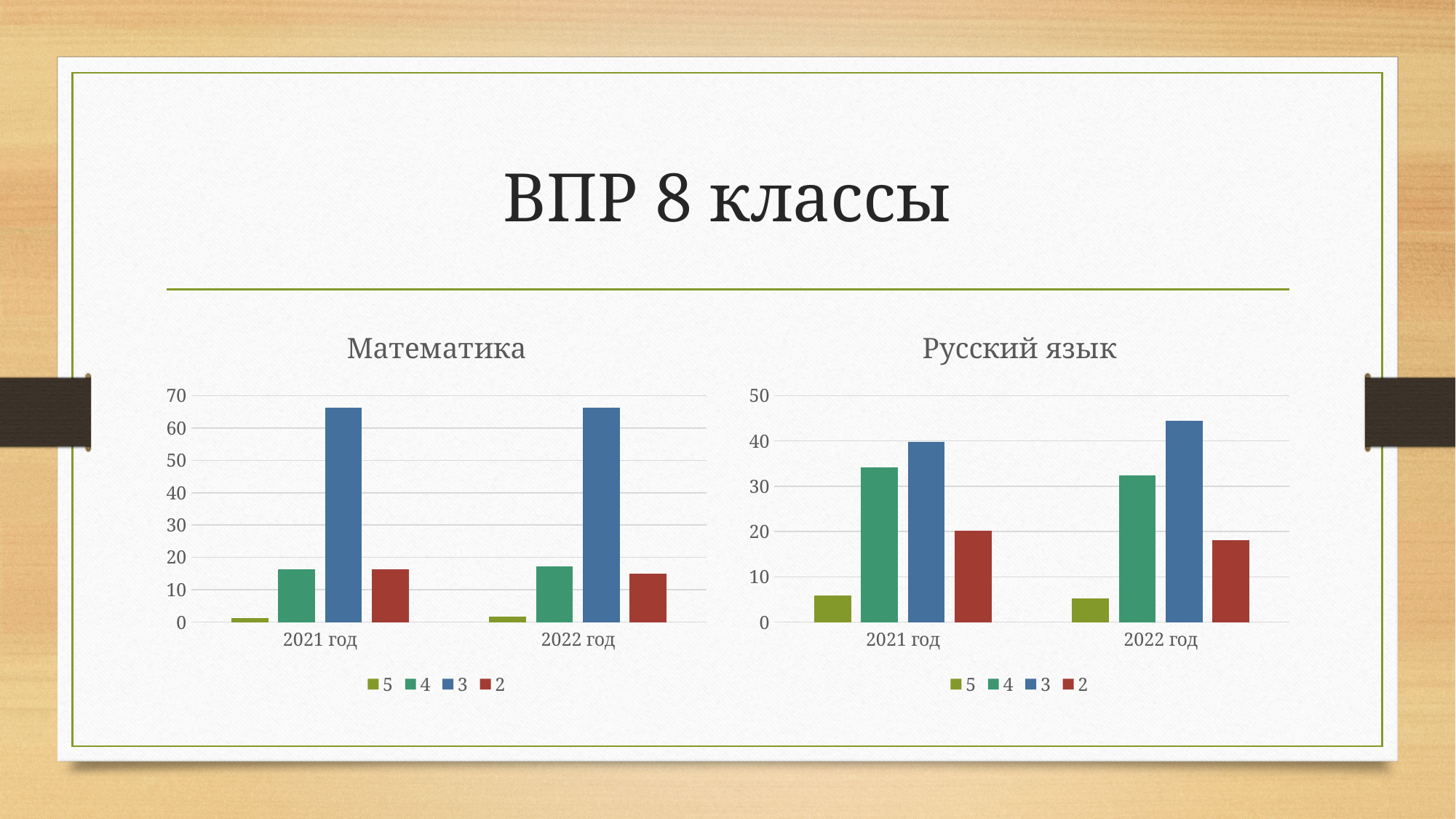
In the "Математика" chart, is the value for series 3 in 2021 год greater or less than 60? greater In the "Русский язык" chart, is the value for series 3 in 2022 год greater or less than 40? greater In the "Математика" chart, which series has the highest bar for 2021 год? 3 In the "Русский язык" chart, which is larger for series 3: 2021 год or 2022 год? 2022 год In the "Математика" chart, is the value for series 4 in 2021 год greater or less than 20? less In the "Русский язык" chart, which is larger for 2021 год: series 4 or series 2? 4 How many series does the legend of the "Русский язык" chart list? 4 In the "Русский язык" chart, which series has the lowest bar for 2022 год? 5 How many categories are shown on the x axis of the "Математика" chart? 2 What is the title of the chart on the right side of the slide? Русский язык What kind of chart is the "Математика" chart? bar chart